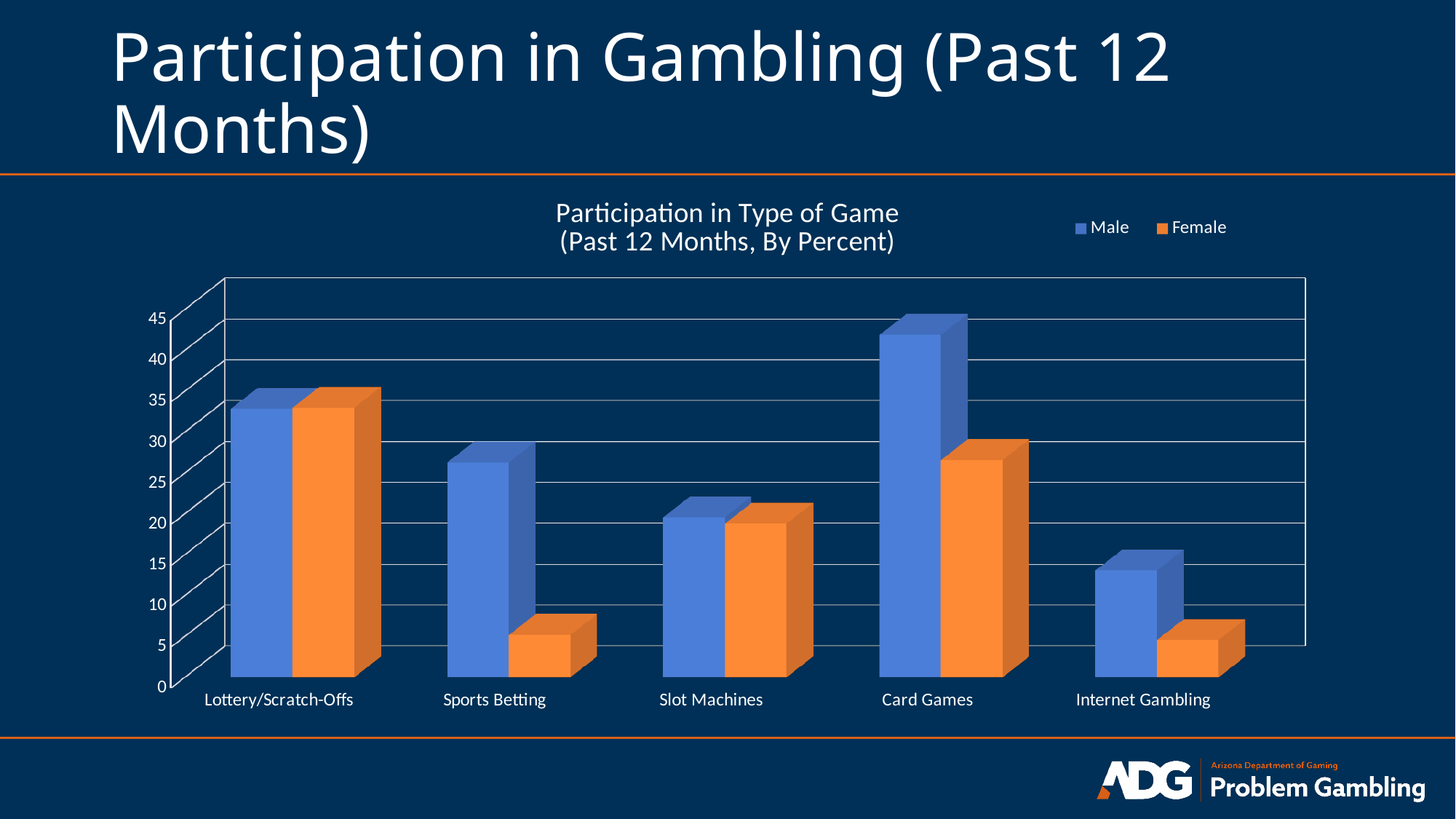
For Sports Betting, which is larger, the Male or the Female value? Male Which type of game has the lowest Male participation? Internet Gambling Which colour represents the Female series in the chart? Orange What kind of chart is shown on the slide? Bar chart Is the Female value for Sports Betting greater or less than 10? less Is the Male value for Card Games greater or less than 40? greater Which type of game has the highest Male participation? Card Games How many series does the legend list? 2 Is the Male value for Internet Gambling greater or less than 20? less How many types of game are shown on the x axis? 5 Which type of game has the highest Female participation? Lottery/Scratch-Offs For Card Games, which is larger, the Male or the Female value? Male